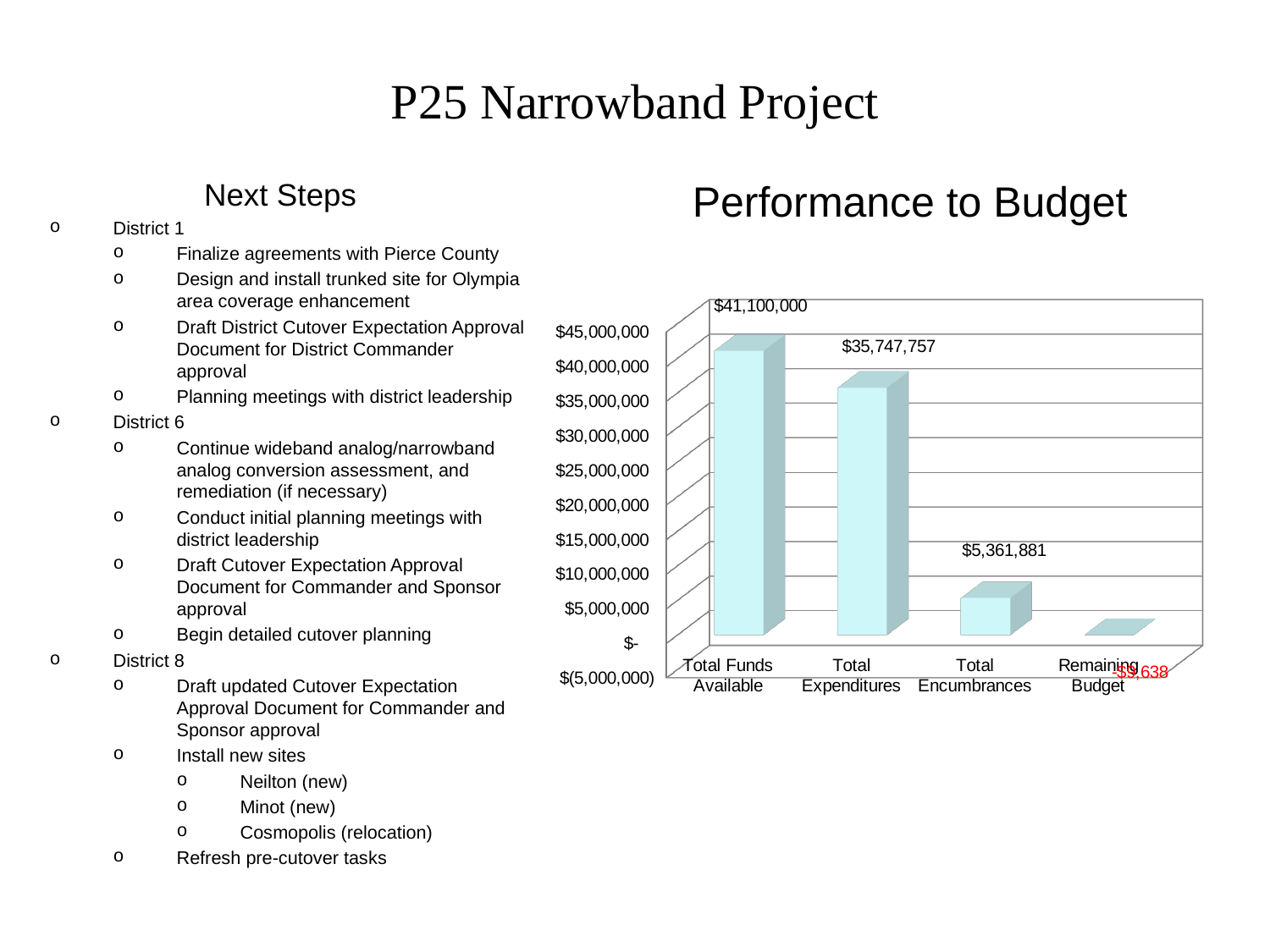
Which is larger, Total Expenditures or Total Encumbrances? Total Expenditures Which category has the highest value? Total Funds Available What kind of chart is shown on the slide? bar chart What is the value for Total Expenditures? $35,747,757 What is the value for Total Encumbrances? $5,361,881 What is the difference between Total Funds Available and Total Expenditures? $5,352,243 How many categories are shown on the chart? 4 What is the difference between Total Expenditures and Total Encumbrances? $30,385,876 What is the value for Total Funds Available? $41,100,000 Is the value for Remaining Budget greater or less than $5,000,000? less Which category has the lowest value? Remaining Budget What is the title of the chart? Performance to Budget